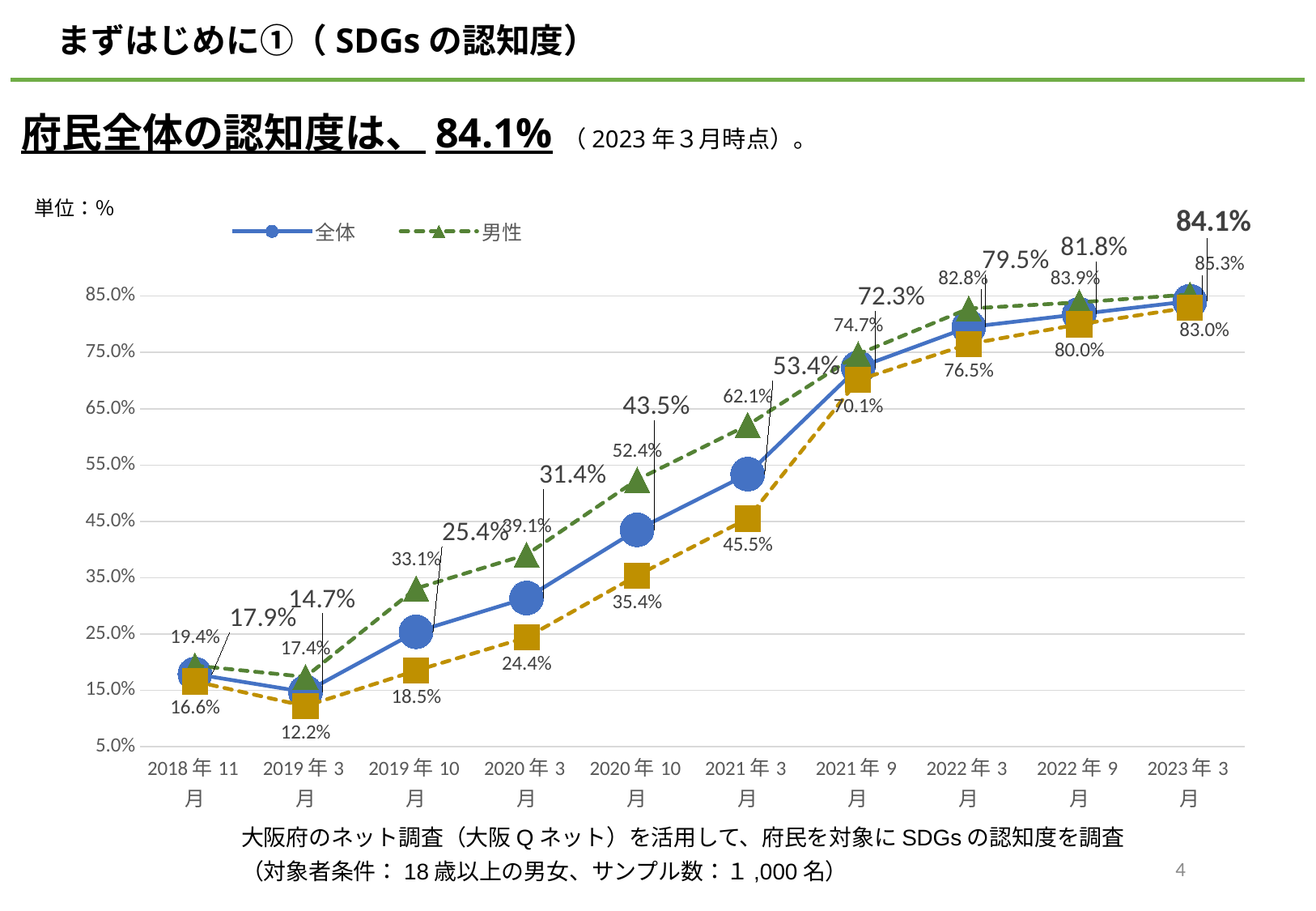
By how much did the 全体 value increase from 2021年3月 to 2021年9月? 18.9 percentage points At which time point is the 男性 value highest? 2023年3月 At 2021年9月, which is larger: the 全体 value or the 男性 value? 男性 At which time point is the 全体 value lowest? 2019年3月 What is the value of 全体 at 2023年3月? 84.1% What is the value of 男性 at 2021年3月? 62.1% What is the value of 全体 at 2019年10月? 25.4% What kind of chart is shown on the slide? Line chart What is the value of 男性 at 2018年11月? 19.4% Does the 全体 value rise or fall from 2019年3月 to 2023年3月? Rises How many time points are shown on the x axis? 10 What is the difference between the 男性 and 全体 values at 2023年3月? 1.2 percentage points